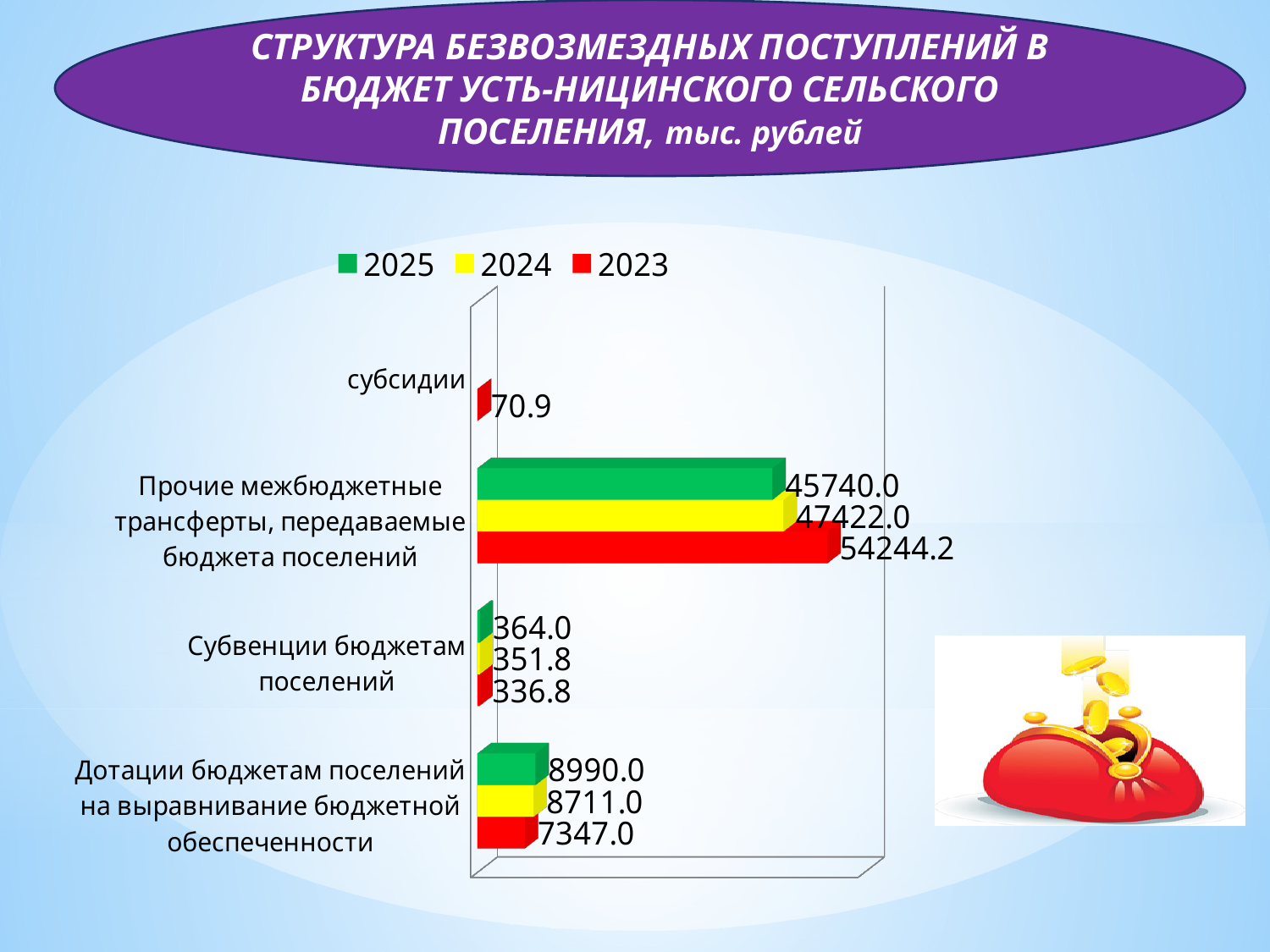
Which year has the lowest value for Дотации бюджетам поселений на выравнивание бюджетной обеспеченности? 2023 What is the 2023 value for Дотации бюджетам поселений на выравнивание бюджетной обеспеченности? 7347.0 What is the difference between the 2023 and 2025 values for Прочие межбюджетные трансферты, передаваемые бюджета поселений? 8504.2 How many series does the legend list? 3 What is the 2024 value for Субвенции бюджетам поселений? 351.8 What type of chart is shown on the slide? bar chart What is the 2023 value for субсидии? 70.9 What is the 2025 value for Прочие межбюджетные трансферты, передаваемые бюджета поселений? 45740.0 Which series is shown in green in the legend? 2025 Which year has the highest value for Прочие межбюджетные трансферты, передаваемые бюджета поселений? 2023 Which is larger for Субвенции бюджетам поселений: the 2025 value or the 2023 value? 2025 How many categories are shown on the chart? 4